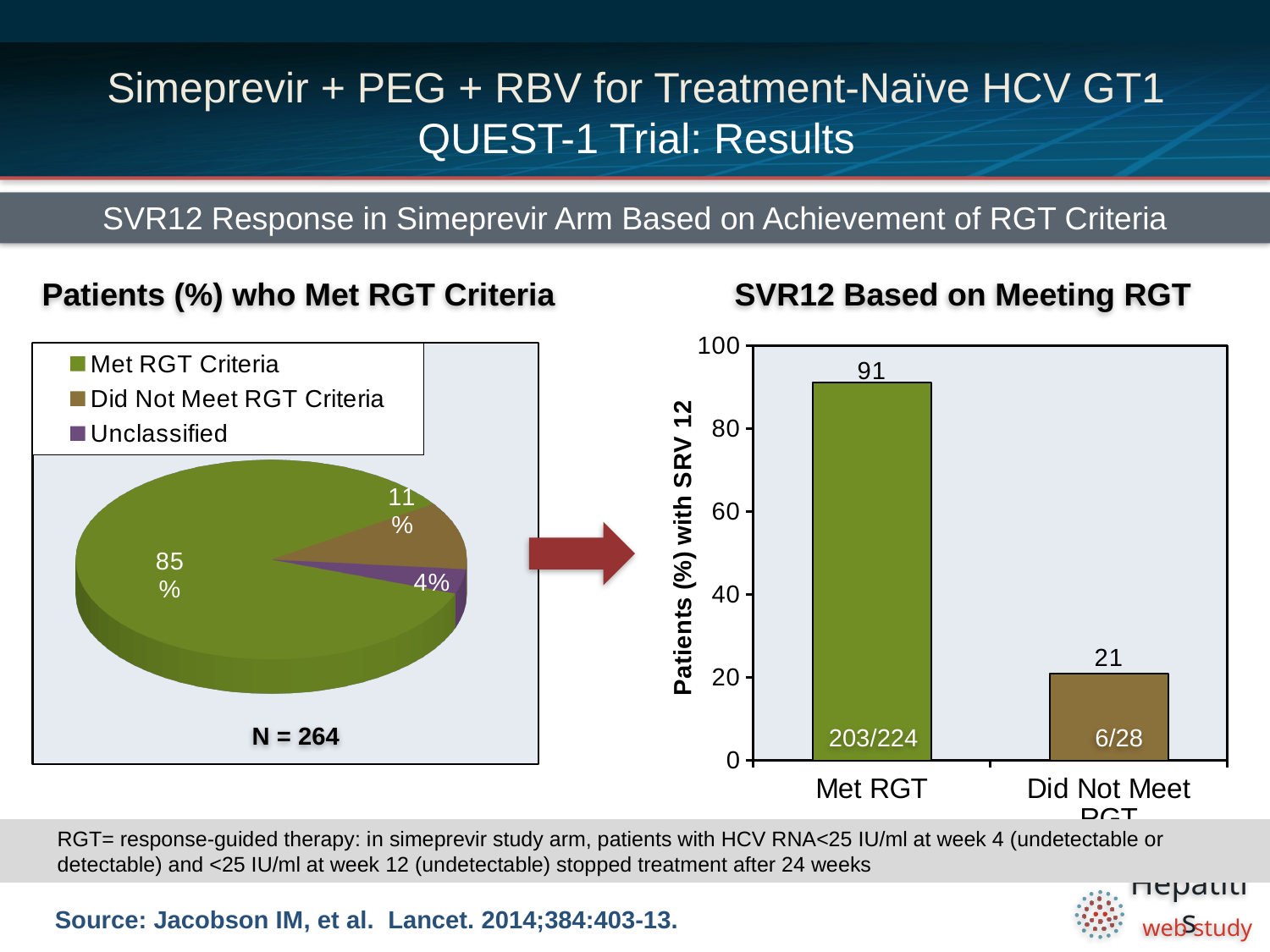
In the pie chart 'Patients (%) who Met RGT Criteria', what percentage of patients did not meet RGT criteria? 11% In the pie chart 'Patients (%) who Met RGT Criteria', how many categories does the legend list? 3 In the bar chart 'SVR12 Based on Meeting RGT', what is the SVR12 value for patients who did not meet RGT? 21 What kind of chart is 'SVR12 Based on Meeting RGT'? Bar chart In the pie chart 'Patients (%) who Met RGT Criteria', what is the total number of patients (N) shown? N = 264 In the pie chart 'Patients (%) who Met RGT Criteria', what percentage of patients met RGT criteria? 85% In the pie chart 'Patients (%) who Met RGT Criteria', what percentage of patients are unclassified? 4% In the pie chart 'Patients (%) who Met RGT Criteria', which category has the smallest slice? Unclassified In the bar chart 'SVR12 Based on Meeting RGT', what is the SVR12 value for patients who met RGT? 91 In the bar chart 'SVR12 Based on Meeting RGT', what fraction is printed inside the Did Not Meet RGT bar? 6/28 In the bar chart 'SVR12 Based on Meeting RGT', what fraction is printed inside the Met RGT bar? 203/224 In the bar chart 'SVR12 Based on Meeting RGT', what is the difference between the Met RGT and Did Not Meet RGT values? 70